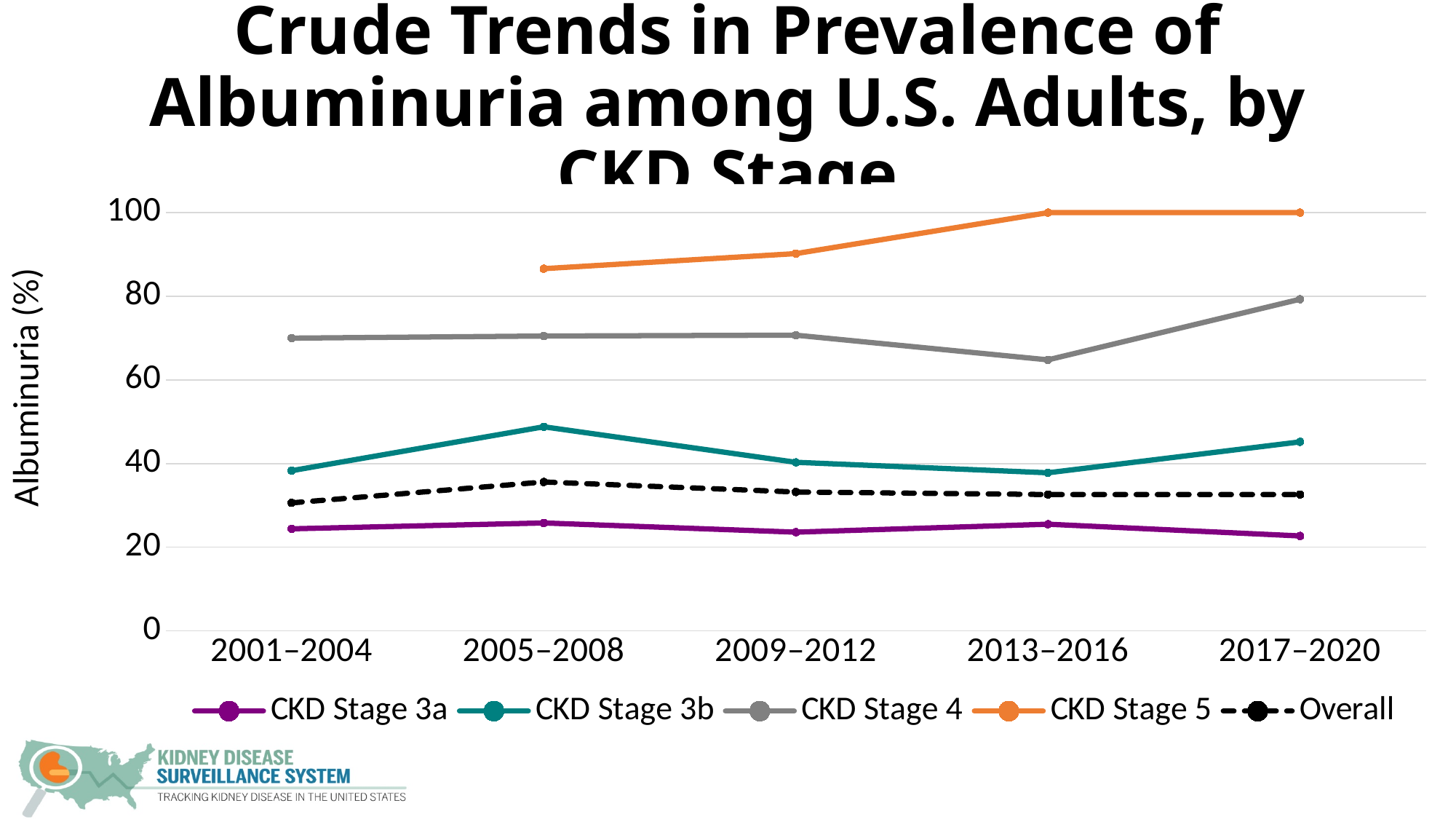
Is the value for CKD Stage 3b in 2005–2008 greater or less than 40? greater Which CKD stage has the highest albuminuria prevalence in 2017–2020? CKD Stage 5 How many series does the legend list? 5 Which is larger in 2005–2008, CKD Stage 3b or Overall? CKD Stage 3b What kind of chart is shown on the slide? line chart How many time periods are shown on the x axis? 5 Which series has the lowest albuminuria prevalence in 2017–2020? CKD Stage 3a Does the CKD Stage 5 line rise or fall from 2005–2008 to 2013–2016? rise Is the value for Overall in 2001–2004 greater or less than 40? less Which series is drawn with a dashed line? Overall What is the albuminuria prevalence for CKD Stage 5 in 2017–2020? 100 Is the value for CKD Stage 4 in 2013–2016 greater or less than 60? greater